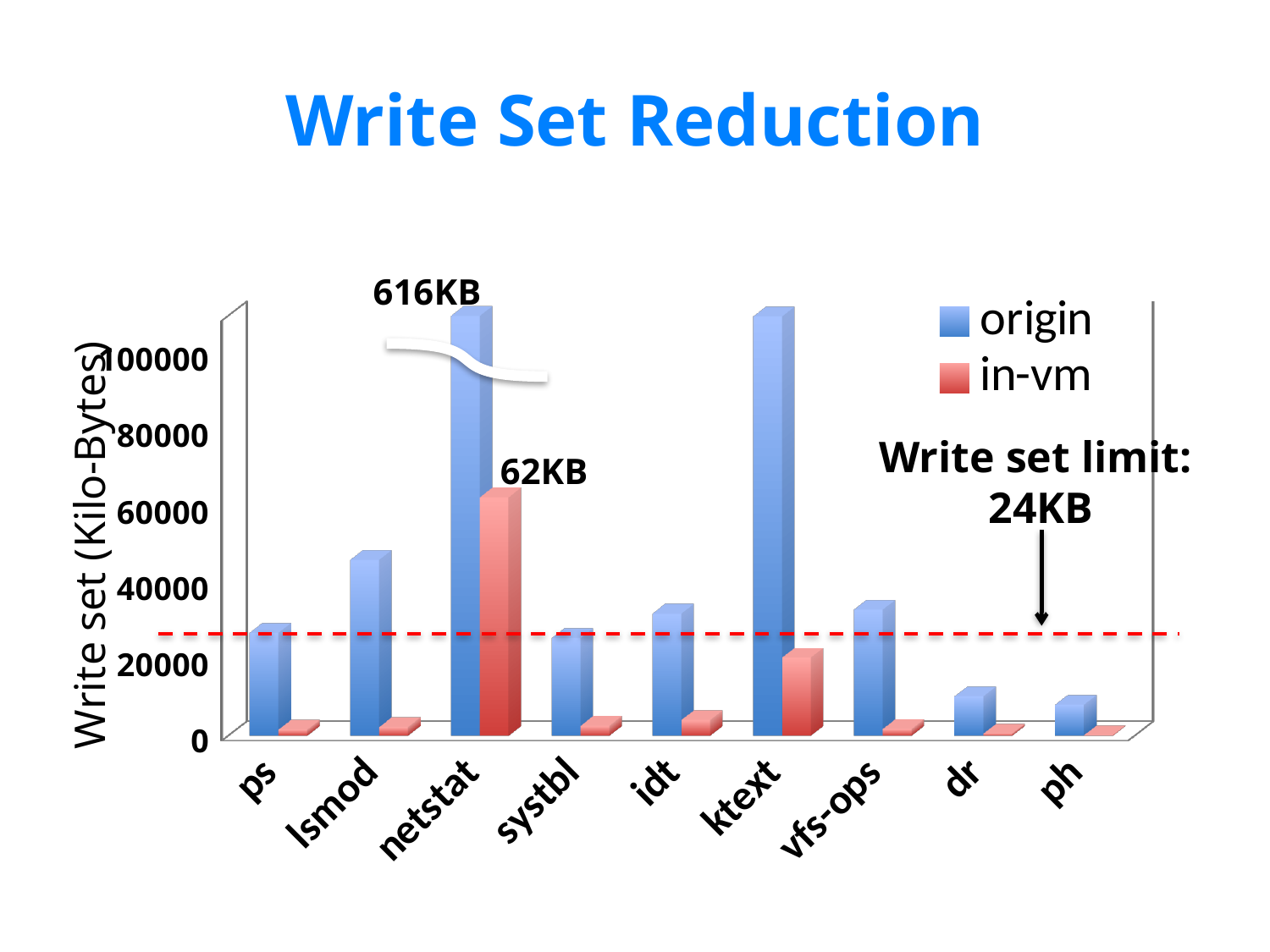
Which category has the highest in-vm value? netstat Is the origin value for vfs-ops greater or less than 40000? less What value is labelled on the in-vm bar for netstat? 62KB How many categories are shown on the x axis of the chart? 9 Is the origin value for lsmod greater or less than 40000? greater Is the origin value for dr greater or less than 20000? less Which is larger, the origin value for lsmod or the origin value for idt? lsmod Which category has the highest origin value? netstat What value is labelled on the origin bar for netstat? 616KB What kind of chart is shown on the slide? bar chart What write set limit is indicated by the dashed line on the chart? 24KB How many series does the chart legend list? 2